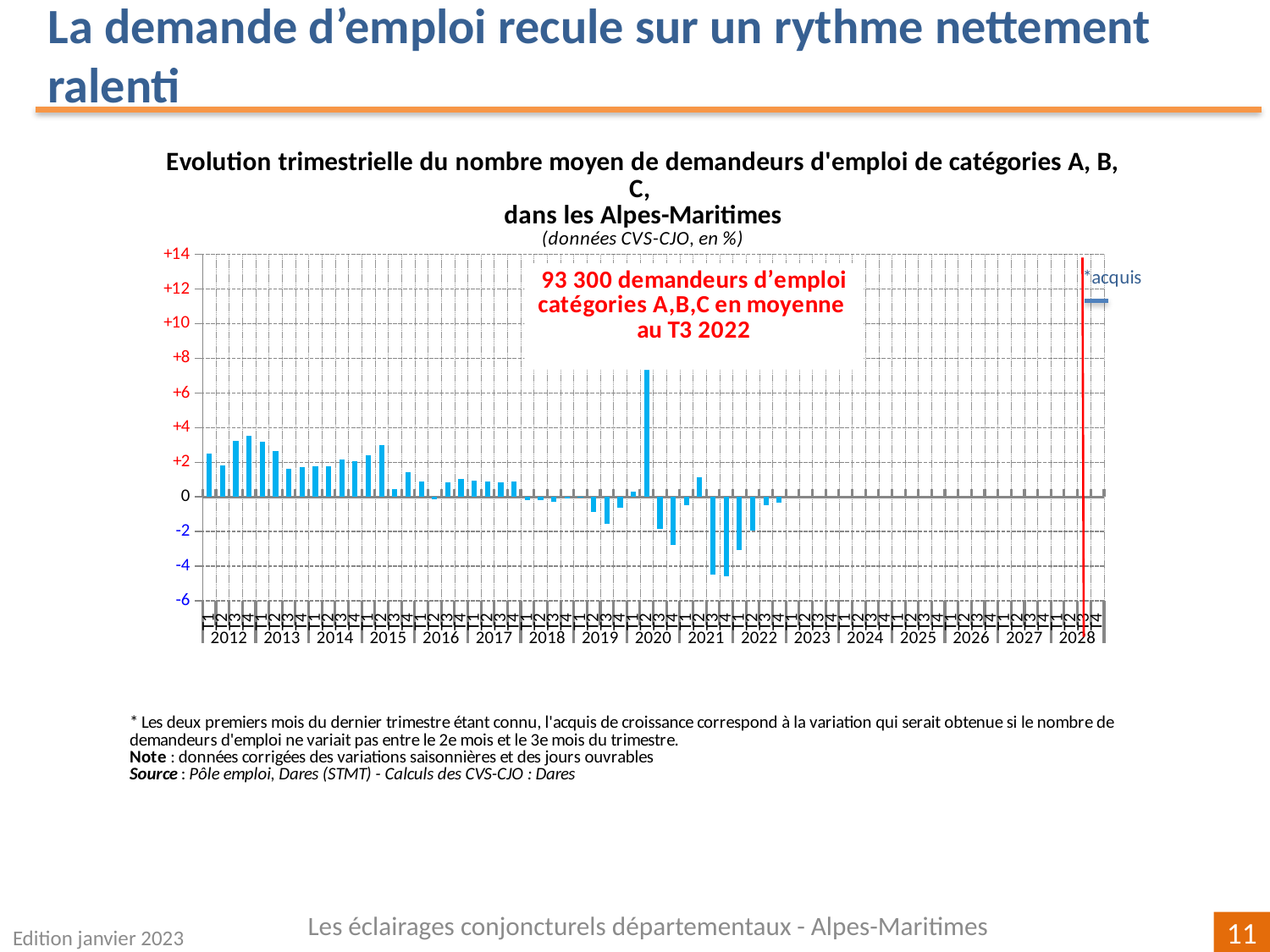
What is the maximum value shown on the y axis? +14 What kind of chart is shown on the slide? Bar chart In which year does the highest bar on the chart occur? 2020 Are the bars for the second and third quarters of 2021 positive or negative? The second quarter of 2021 is positive and the third quarter is negative According to the text box on the chart, how many demandeurs d'emploi catégories A,B,C were there on average in T3 2022? 93 300 How many years are labelled along the x axis of the chart? 17 Is the highest bar on the chart (in 2020) greater or less than +6? greater Is the value for the fourth quarter of 2012 greater or less than +2? greater What is the title of the chart? Evolution trimestrielle du nombre moyen de demandeurs d'emploi de catégories A, B, C, dans les Alpes-Maritimes In which year do the lowest bars on the chart occur? 2021 Which is larger: the highest bar in 2020 or the highest bar in 2012? The highest bar in 2020